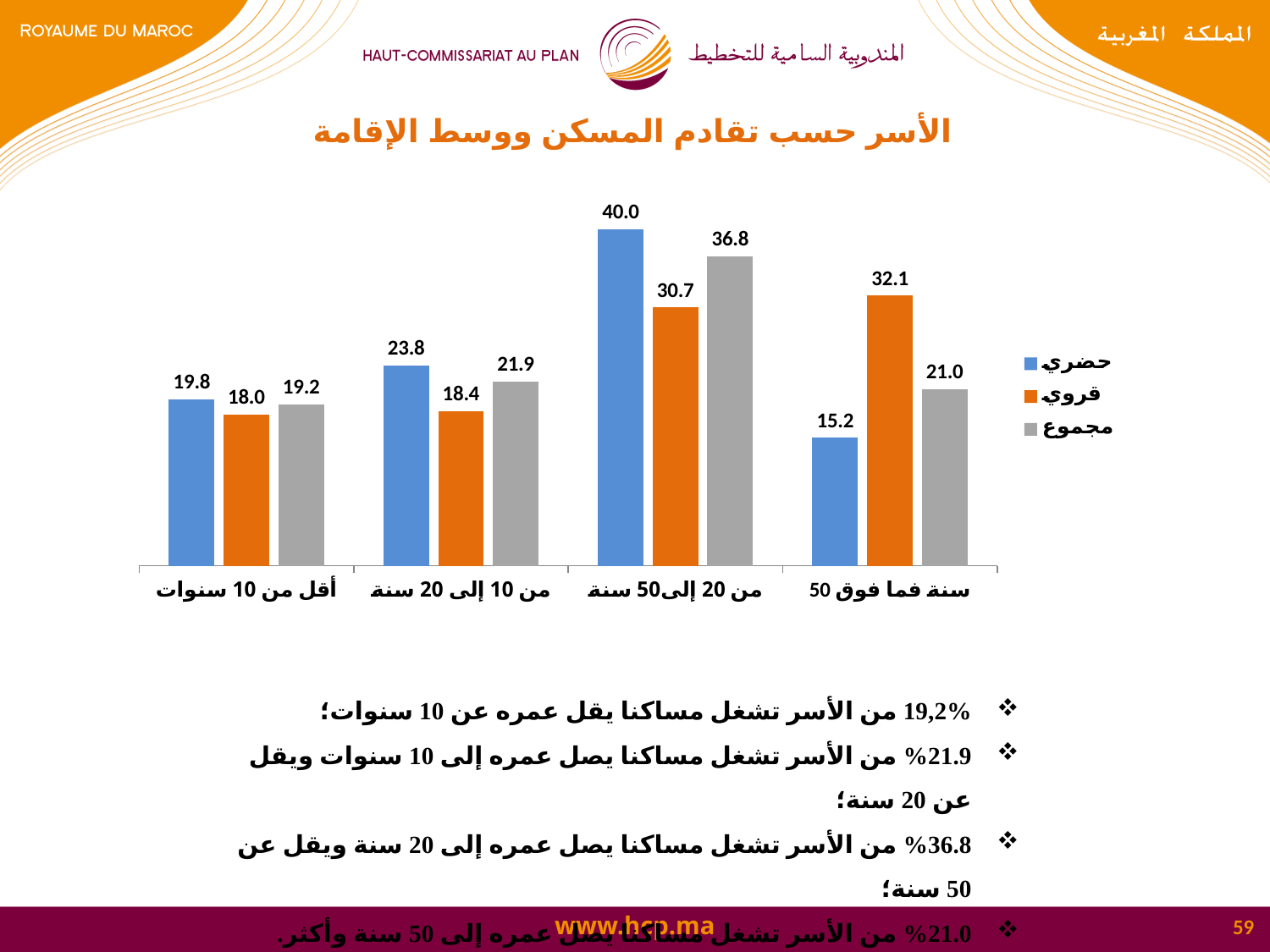
Which category has the lowest value for the حضري (urban) series? 50 سنة فما فوق What is the value for the قروي (rural) series in the category 50 سنة فما فوق (50 years and above)? 32.1 What is the value for the حضري (urban) series in the category من 20 إلى 50 سنة (20 to 50 years)? 40.0 Which colour represents the قروي (rural) series in the chart? Orange Which category has the highest value for the مجموع (total) series? من 20 إلى 50 سنة What is the difference between the حضري (urban) and قروي (rural) values in the category من 20 إلى 50 سنة (20 to 50 years)? 9.3 What is the value for the مجموع (total) series in the category من 10 إلى 20 سنة (10 to 20 years)? 21.9 What is the value for the قروي (rural) series in the category أقل من 10 سنوات (less than 10 years)? 18.0 How many series does the chart legend list? 3 How many categories are shown on the x axis of the chart? 4 What kind of chart is shown on the slide? Bar chart In the category 50 سنة فما فوق (50 years and above), which is larger: the حضري (urban) value or the قروي (rural) value? قروي